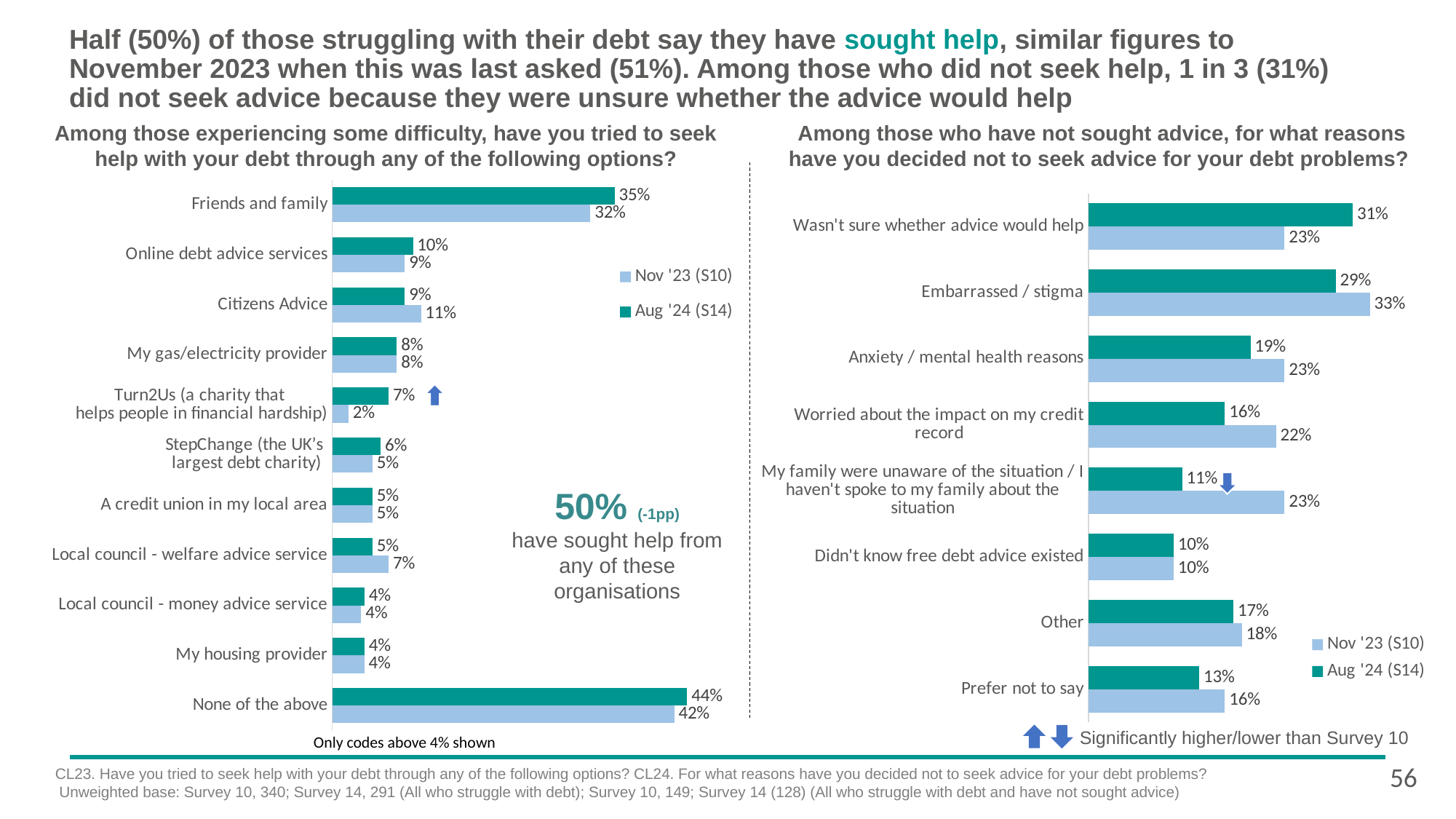
In the right chart (reasons for not seeking advice), is the Aug '24 (S14) value for Anxiety / mental health reasons larger or smaller than the Nov '23 (S10) value? smaller In the right chart (reasons for not seeking advice), which category has the lowest Aug '24 (S14) value? Didn't know free debt advice existed In the right chart (reasons for not seeking advice), what is the difference between the Nov '23 (S10) and Aug '24 (S14) values for My family were unaware of the situation? 12 percentage points In the left chart (have you tried to seek help with your debt), which category has the highest Aug '24 (S14) value? None of the above In the right chart (reasons for not seeking advice), what is the Aug '24 (S14) value for Wasn't sure whether advice would help? 31% In the right chart (reasons for not seeking advice), what is the Nov '23 (S10) value for Embarrassed / stigma? 33% In the left chart (have you tried to seek help with your debt), what is the Nov '23 (S10) value for Citizens Advice? 11% In the left chart (have you tried to seek help with your debt), what is the Aug '24 (S14) value for Friends and family? 35% In the left chart (have you tried to seek help with your debt), how many categories are shown? 11 In the left chart (have you tried to seek help with your debt), how many series does the legend list? 2 In the left chart (have you tried to seek help with your debt), what is the difference between the Aug '24 (S14) and Nov '23 (S10) values for Turn2Us? 5 percentage points What type of chart is used on the right side of the slide (reasons for not seeking advice)? Bar chart